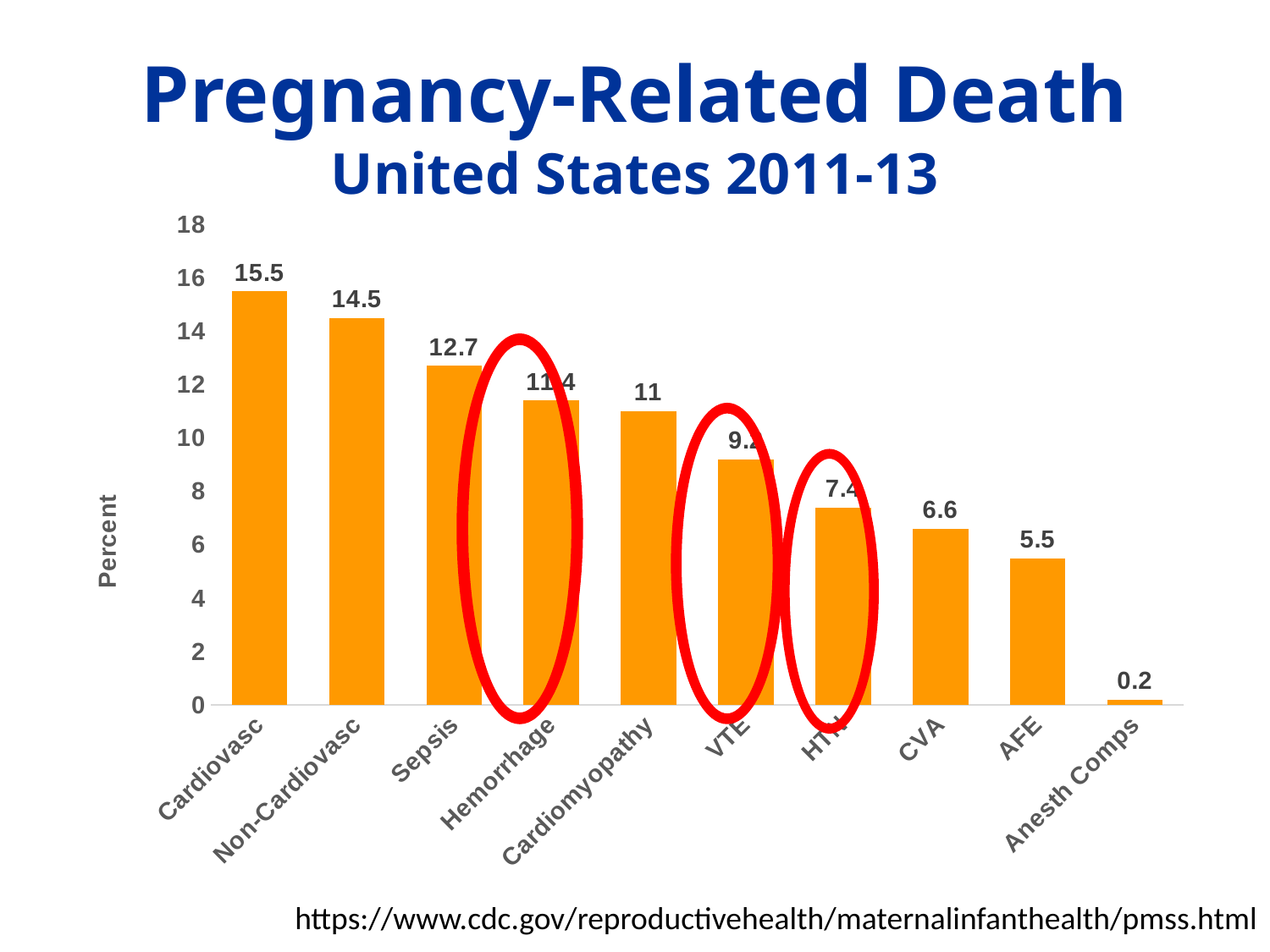
What is the value for Anesth Comps? 0.2 Is the value for Hemorrhage greater or less than 10? greater What is the difference between the values for Cardiovasc and Non-Cardiovasc? 1 What is the value for CVA? 6.6 Which category has the highest value? Cardiovasc What is the difference between the values for CVA and AFE? 1.1 What is the value for Cardiovasc? 15.5 Which is larger, the value for Sepsis or the value for Cardiomyopathy? Sepsis How many categories are shown on the x axis? 10 What kind of chart is shown on the slide? bar chart What is the value for Sepsis? 12.7 Which category has the lowest value? Anesth Comps